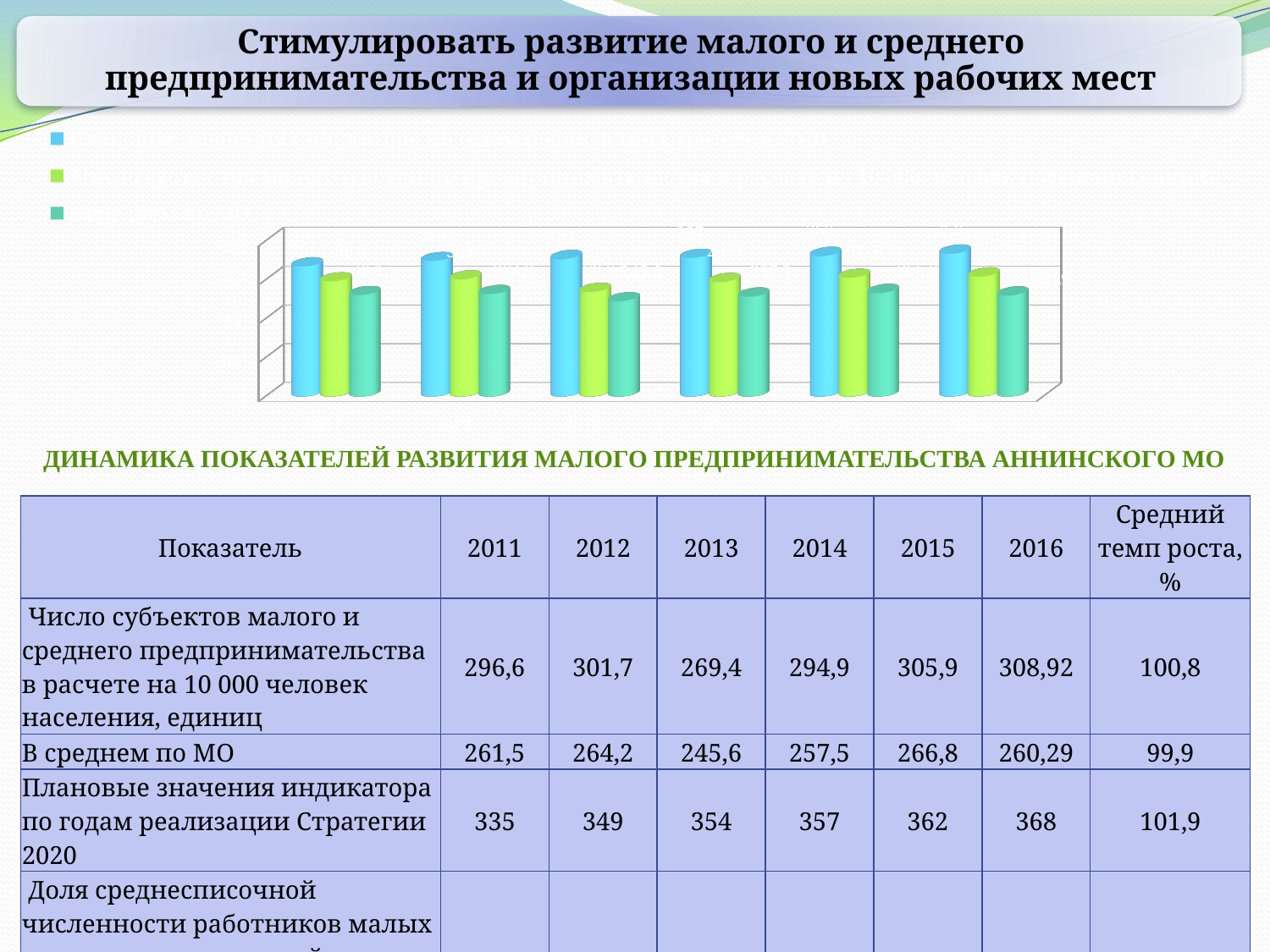
How many groups of bars does the chart contain? 6 In the leftmost group of bars, which colour bar is the tallest? blue In the leftmost group of bars, which colour bar is the shortest? teal Which is taller: the blue bar in the rightmost group or the blue bar in the leftmost group? the rightmost group In which group of bars is the blue bar the tallest? the rightmost (sixth) group Do the blue bars generally rise or fall from left to right across the chart? rise Are the bars in the chart drawn as flat 2D bars or as 3D cylinders? 3D cylinders How many colour markers does the legend above the chart show? 3 How many bars are plotted in the chart in total? 18 How many series (bar colours) are plotted in the chart? 3 What kind of chart is shown on the slide? bar chart